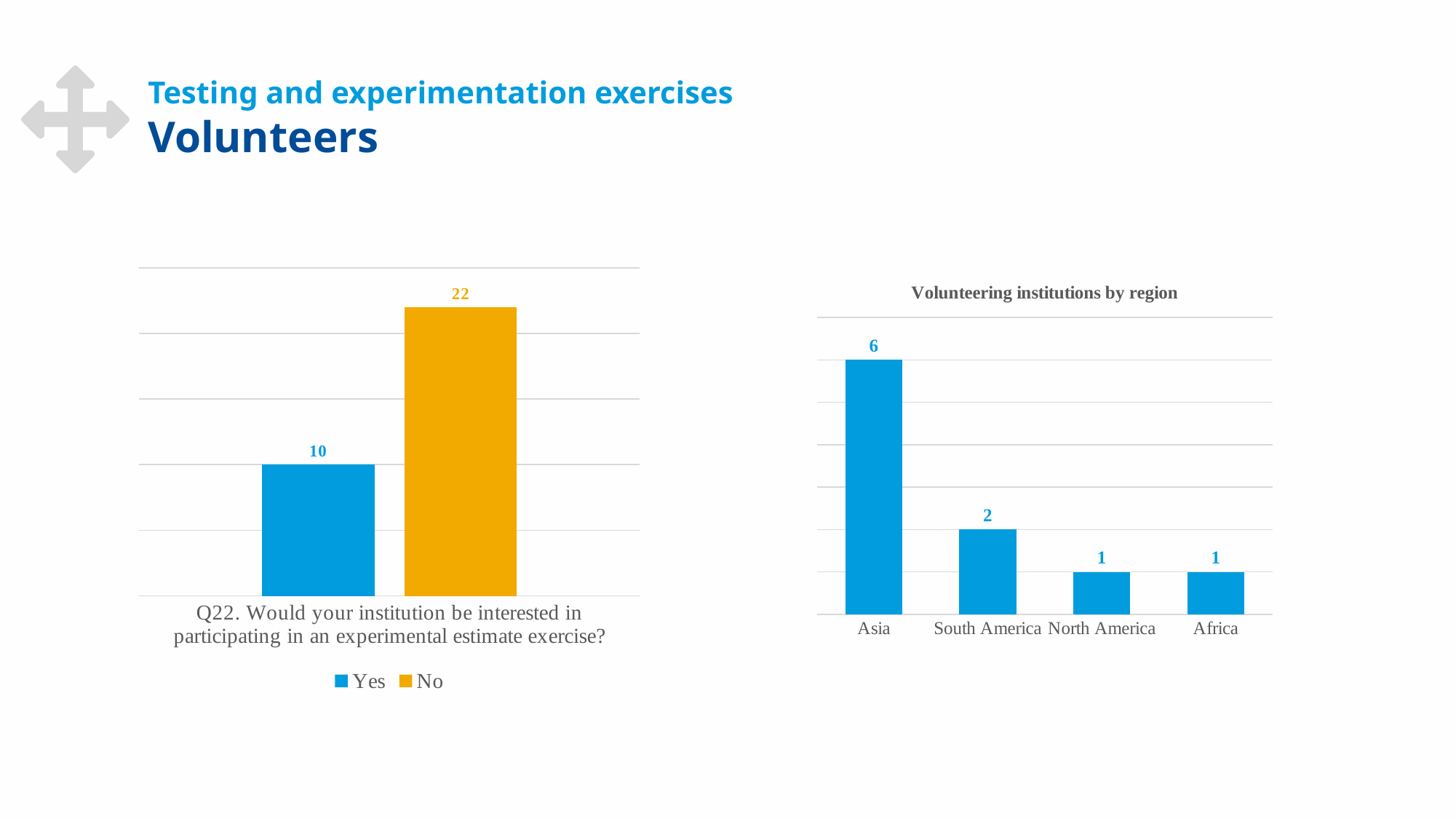
In the 'Volunteering institutions by region' chart, which region has the highest value? Asia In the left chart (Q22), what is the value for Yes? 10 What kind of chart is the 'Volunteering institutions by region' chart? bar chart In the 'Volunteering institutions by region' chart, what is the value for Asia? 6 In the left chart (Q22), what is the value for No? 22 In the left chart (Q22), which is larger, Yes or No? No In the 'Volunteering institutions by region' chart, do the values rise or fall from left to right? fall In the 'Volunteering institutions by region' chart, what is the value for South America? 2 In the left chart (Q22), how many series does the legend list? 2 In the left chart (Q22), what is the difference between the No and Yes values? 12 In the 'Volunteering institutions by region' chart, how many regions are shown? 4 In the 'Volunteering institutions by region' chart, what is the difference between Asia and South America? 4